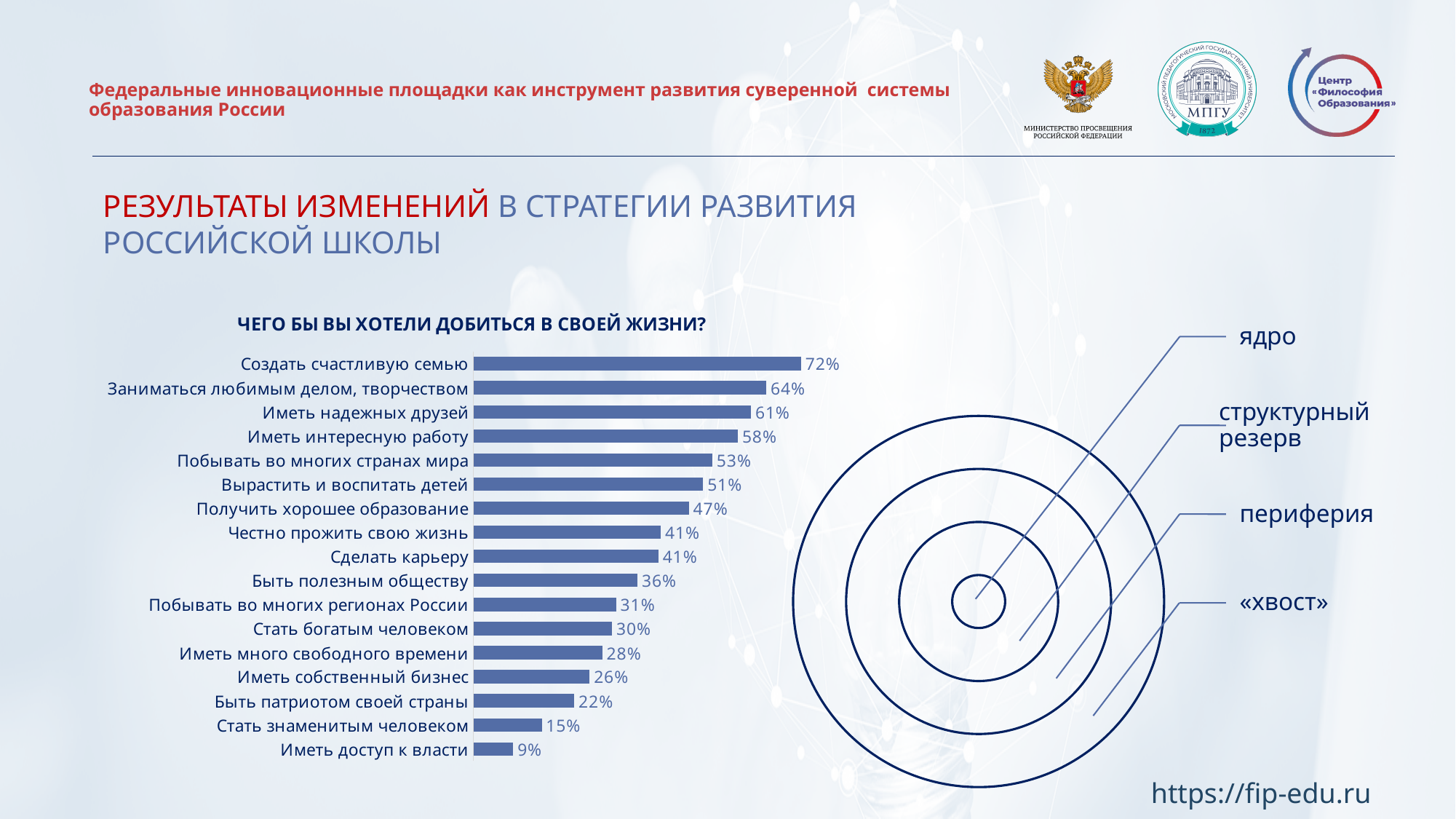
What kind of chart is used to show the survey results? Bar chart Which is larger: «Стать богатым человеком» or «Побывать во многих странах мира»? Побывать во многих странах мира What is the difference between «Создать счастливую семью» and «Иметь доступ к власти»? 63% What value is shown for «Получить хорошее образование»? 47% What value is shown for «Быть патриотом своей страны»? 22% Which category has the highest value? Создать счастливую семью What is the difference between «Заниматься любимым делом, творчеством» and «Иметь надежных друзей»? 3% Which category has the lowest value? Иметь доступ к власти What is the title of the chart? ЧЕГО БЫ ВЫ ХОТЕЛИ ДОБИТЬСЯ В СВОЕЙ ЖИЗНИ? What value is shown for «Создать счастливую семью»? 72% How many categories does the bar chart show? 17 Which is larger: «Сделать карьеру» or «Быть полезным обществу»? Сделать карьеру